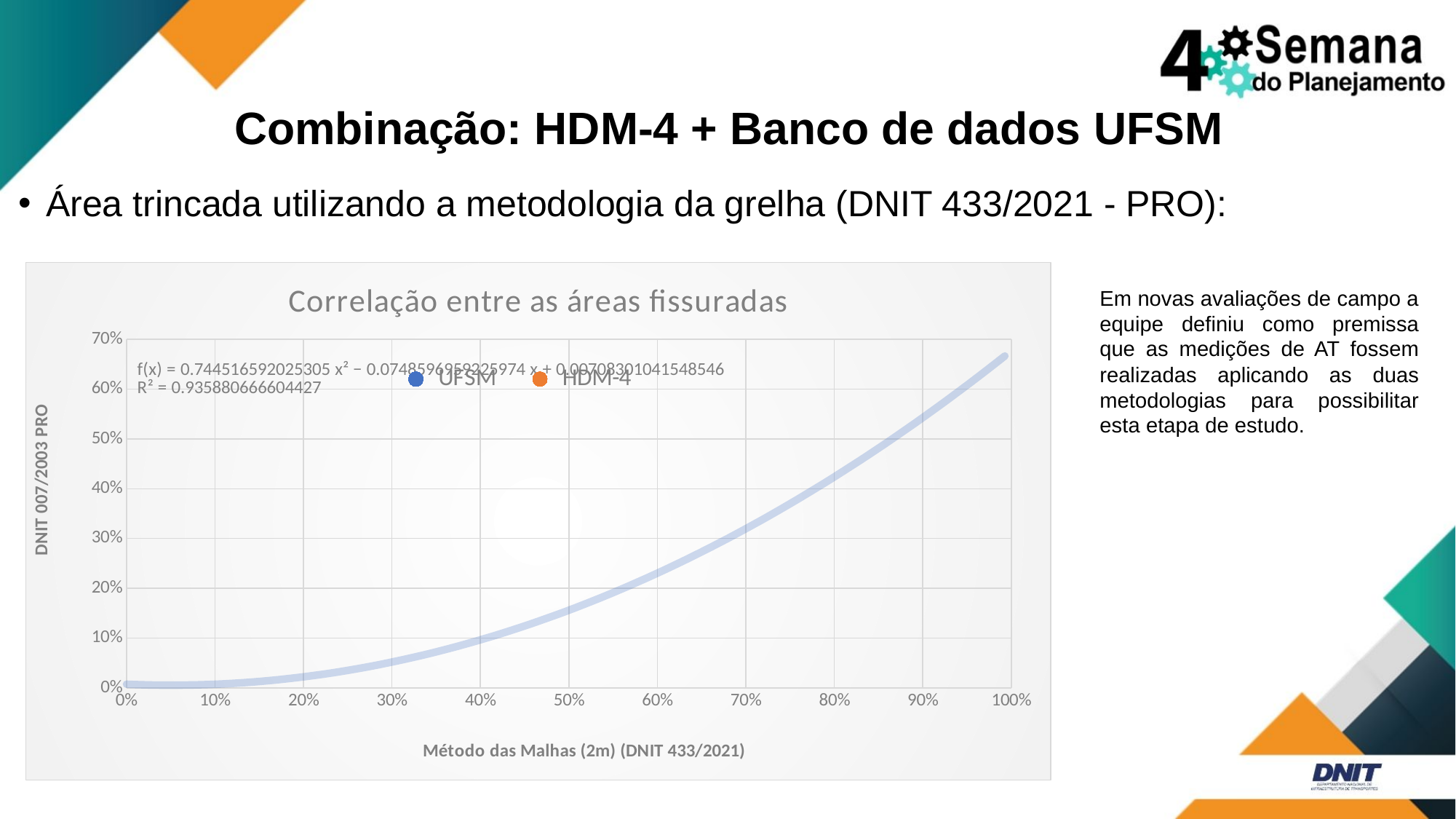
What is the R² value printed on the chart? R² = 0.935880666604427 What is the maximum value shown on the y axis of the chart? 70% Is the value of the curve at 90% on the x axis greater or less than 50%? greater Is the value of the curve at 70% on the x axis greater or less than 40%? less How many series does the chart legend list? 2 What is the title of the chart? Correlação entre as áreas fissuradas Is the value of the curve at 100% on the x axis greater or less than 60%? greater What is the label of the x axis of the chart? Método das Malhas (2m) (DNIT 433/2021) Does the plotted curve rise or fall as the x-axis value increases from 0% to 100%? rise